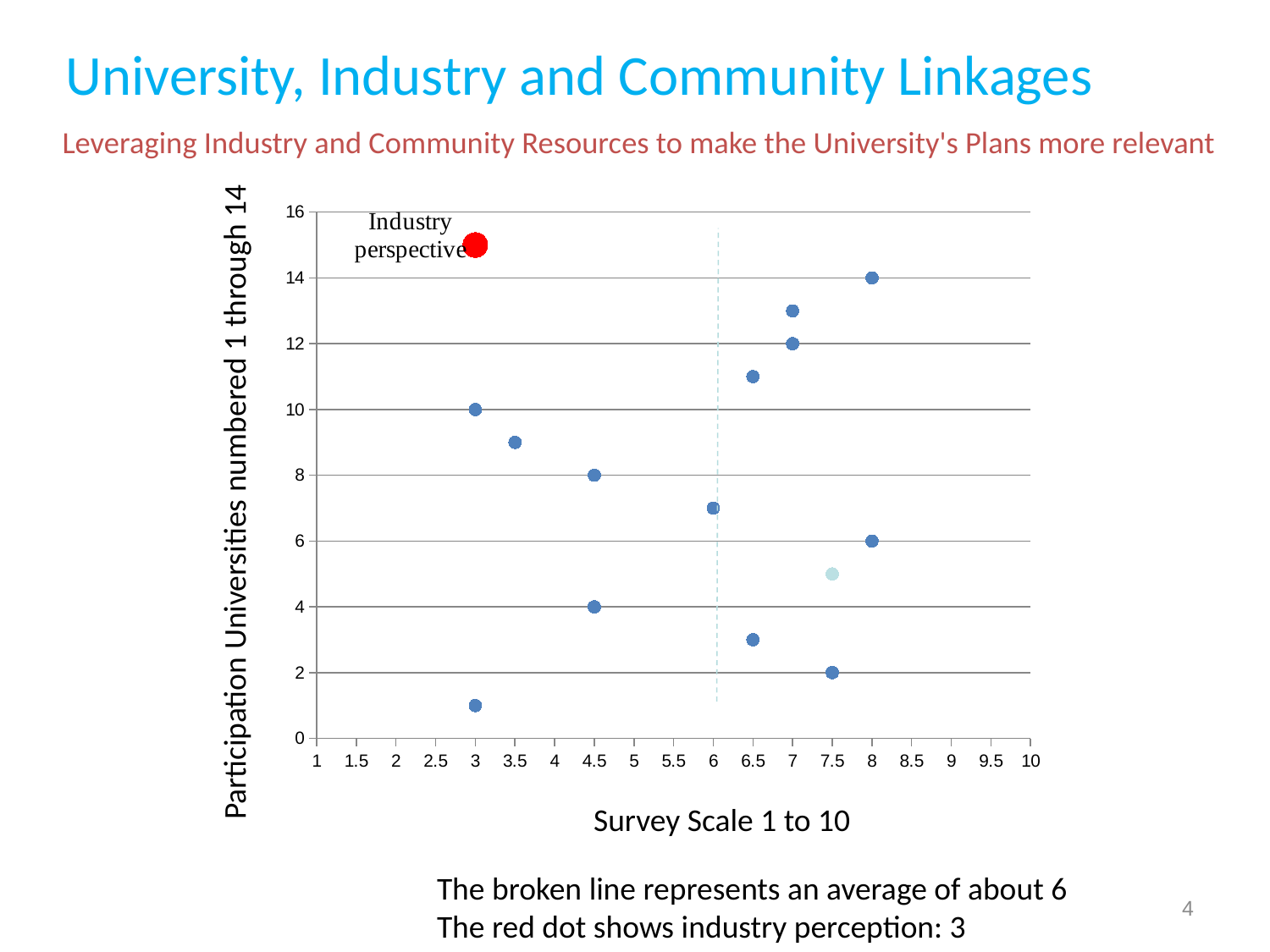
What survey scale value is plotted for university 2? 7.5 What is the difference between the survey scale values of university 14 and university 10? 5 What label is attached to the red dot in the chart? Industry perspective What survey scale value is plotted for university 10? 3 What survey scale value does the red dot (industry perception) show? 3 What kind of chart is shown on the slide? scatter chart Which has the larger survey scale value, university 14 or university 10? university 14 Is the survey scale value for university 13 greater or less than 6? greater What survey scale value is plotted for university 12? 7 What survey scale value is plotted for university 14? 8 Is the survey scale value for university 1 greater or less than 4? less What is the title of the x axis of the chart? Survey Scale 1 to 10